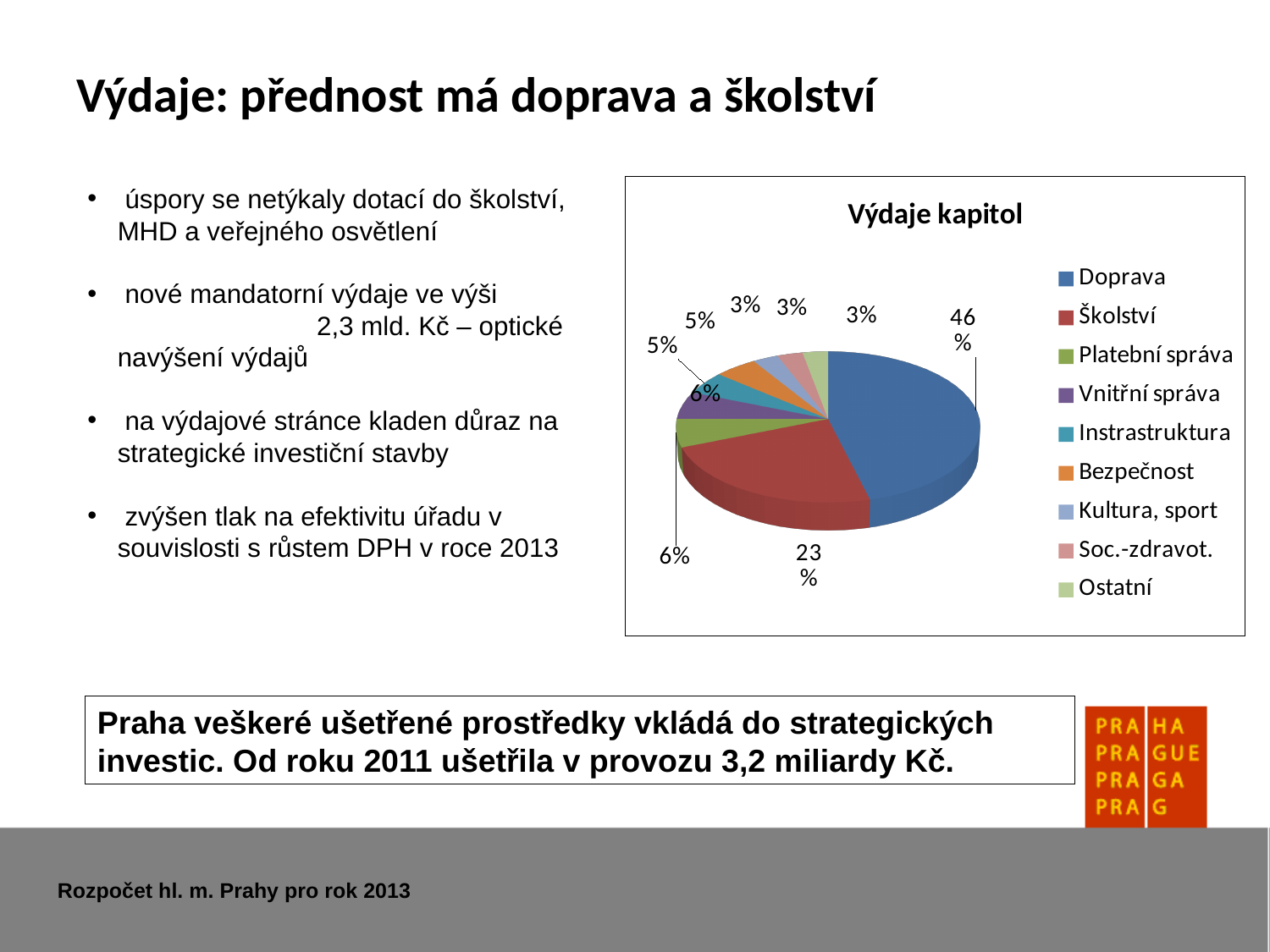
What share of the pie does Doprava have? 46% What kind of chart is shown on the slide? pie chart What share of the pie does Vnitřní správa have? 6% How many categories does the legend list? 9 What colour is the Doprava slice? blue What is the difference in percentage points between Doprava and Školství? 23 What share of the pie does Bezpečnost have? 5% What is the combined share of Doprava and Školství? 69% What share of the pie does Školství have? 23% Which is larger, the share for Školství or the share for Platební správa? Školství Which category has the largest share of the pie? Doprava What is the title of the chart? Výdaje kapitol